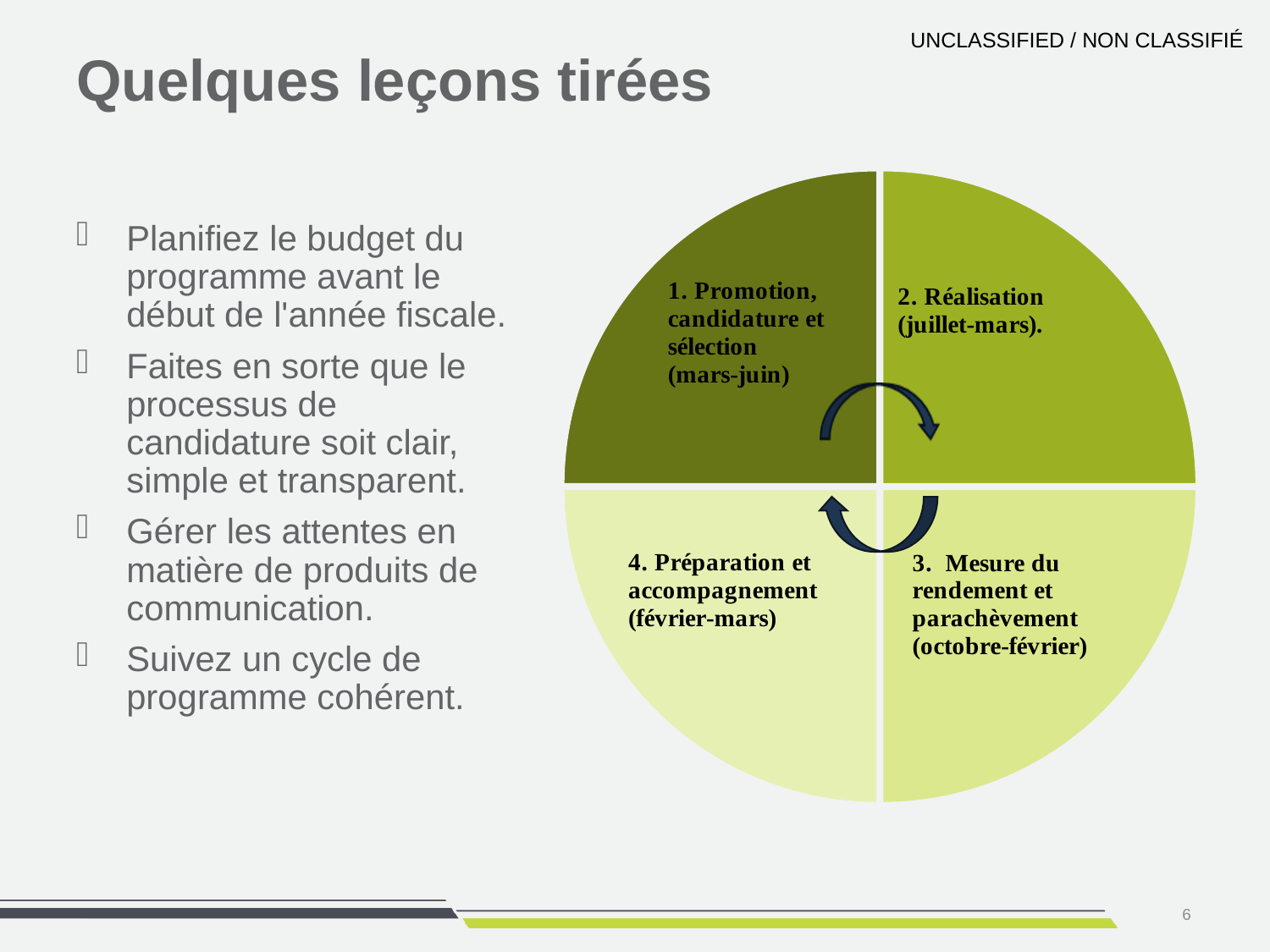
Which months are given for the slice labelled "3. Mesure du rendement et parachèvement"? octobre-février Which months are given for the slice labelled "1. Promotion, candidature et sélection"? mars-juin What kind of chart is shown on the right side of the slide? pie chart How many slices does the pie chart on the slide have? 4 Which months are given for the slice labelled "4. Préparation et accompagnement"? février-mars Which slice of the pie chart is labelled with the period "juillet-mars"? 2. Réalisation Which months are given for the slice labelled "2. Réalisation"? juillet-mars In which quadrant of the pie chart is the slice "3. Mesure du rendement et parachèvement" located? bottom right Which slice of the pie chart is the darkest green? 1. Promotion, candidature et sélection (mars-juin)